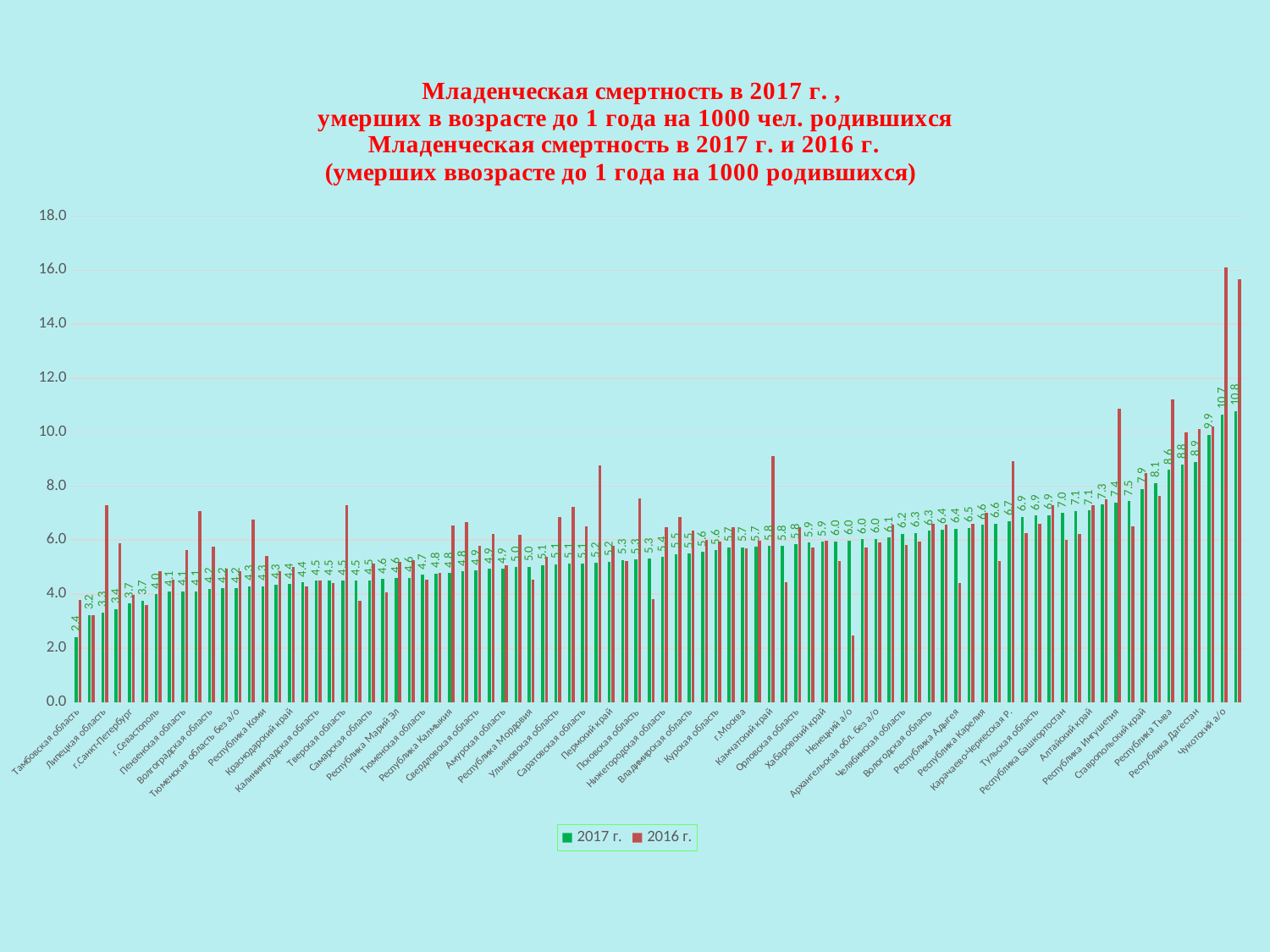
Which two series are listed in the legend? 2017 г. and 2016 г. How many 2017 г. values on the chart are 10.0 or higher? 2 Is the tallest 2016 г. bar on the chart greater or less than 14.0? greater What kind of chart is shown on the slide? bar chart What is the difference between the highest and lowest 2017 г. values on the chart? 8.4 What is the highest 2017 г. value shown on the chart? 10.8 What is the 2017 г. value for Тамбовская область? 2.4 Which colour represents the 2017 г. series? green For Тамбовская область, which is larger: the 2017 г. value or the 2016 г. value? 2016 г. How many series does the legend list? 2 Do the 2017 г. values rise or fall from left to right along the x axis? rise What is the lowest 2017 г. value shown on the chart? 2.4